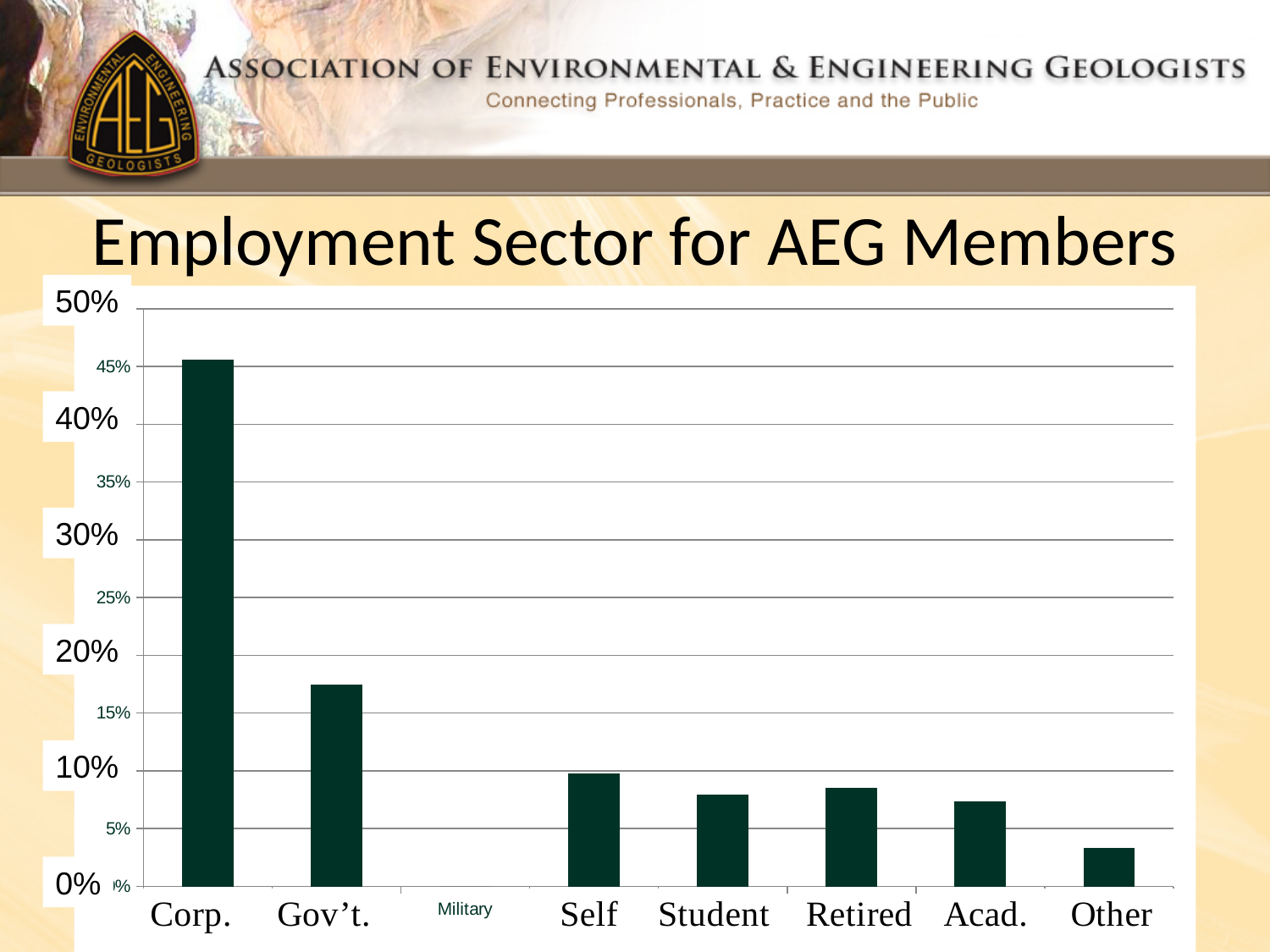
Is the value for Gov't. greater or less than 15%? greater Is the value for Gov't. greater or less than 20%? less What is the title of the chart? Employment Sector for AEG Members How many employment sector categories are shown on the x axis? 8 What type of chart is shown on the slide? bar chart Which is larger, the value for Self or the value for Acad.? Self Is the value for Student greater or less than 5%? greater Which is larger, the value for Gov't. or the value for Self? Gov't. Which employment sector has the lowest share of AEG members? Military Which employment sector has the highest share of AEG members? Corp.